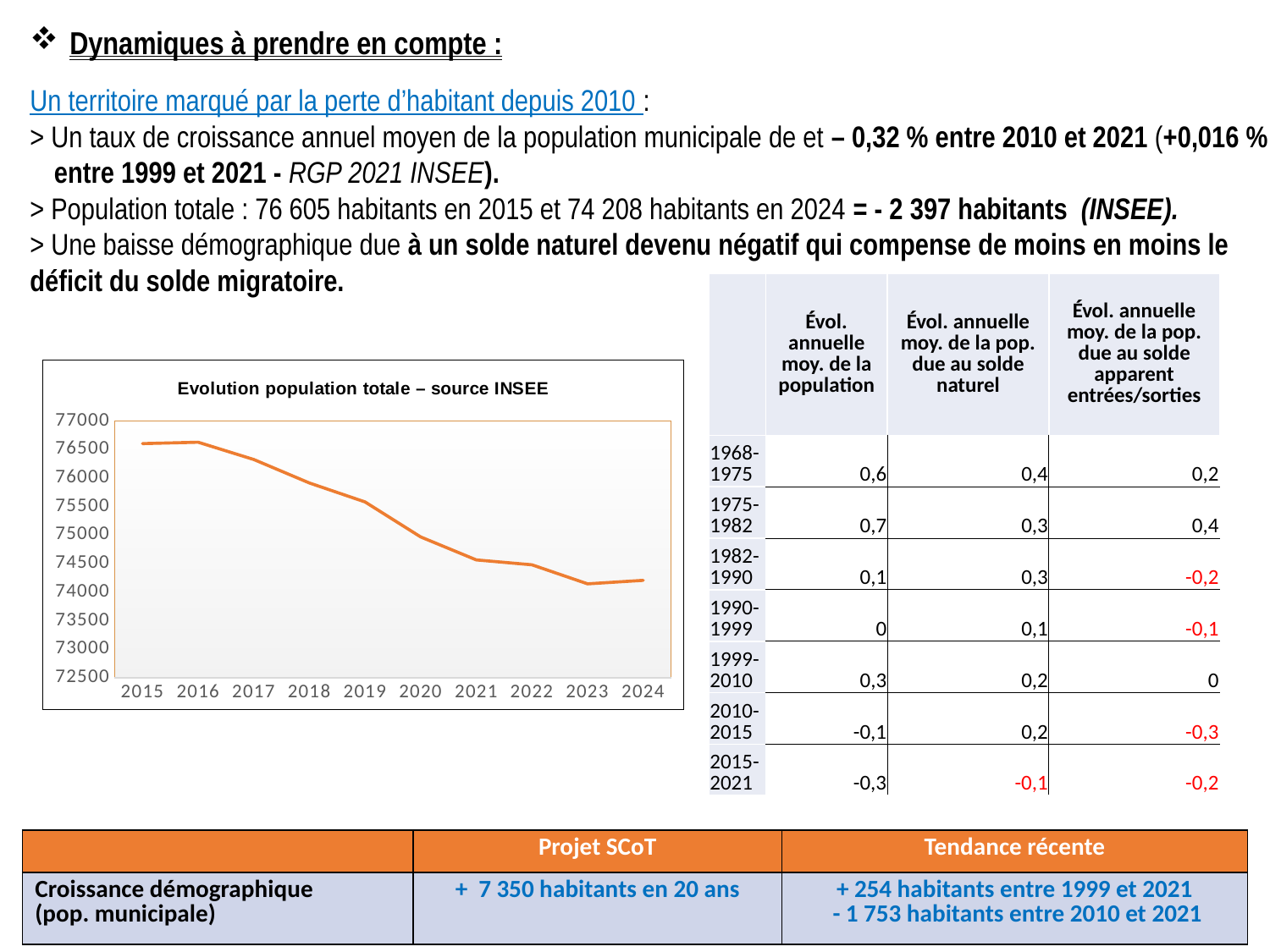
In the 'Evolution population totale' chart, which is larger, the value for 2017 or the value for 2021? 2017 In the 'Evolution population totale' chart, is the value for 2024 greater or less than 74000? greater In the 'Evolution population totale' chart, is the value for 2015 greater or less than 76000? greater In the 'Evolution population totale' chart, is the value for 2019 greater or less than 76000? less What kind of chart is 'Evolution population totale – source INSEE'? line chart What is the title of the line chart on the slide? Evolution population totale – source INSEE In the 'Evolution population totale' chart, which is larger, the value for 2015 or the value for 2024? 2015 How many years are plotted on the x axis of the 'Evolution population totale' chart? 10 Does the population in the 'Evolution population totale' chart rise or fall from 2015 to 2024? fall